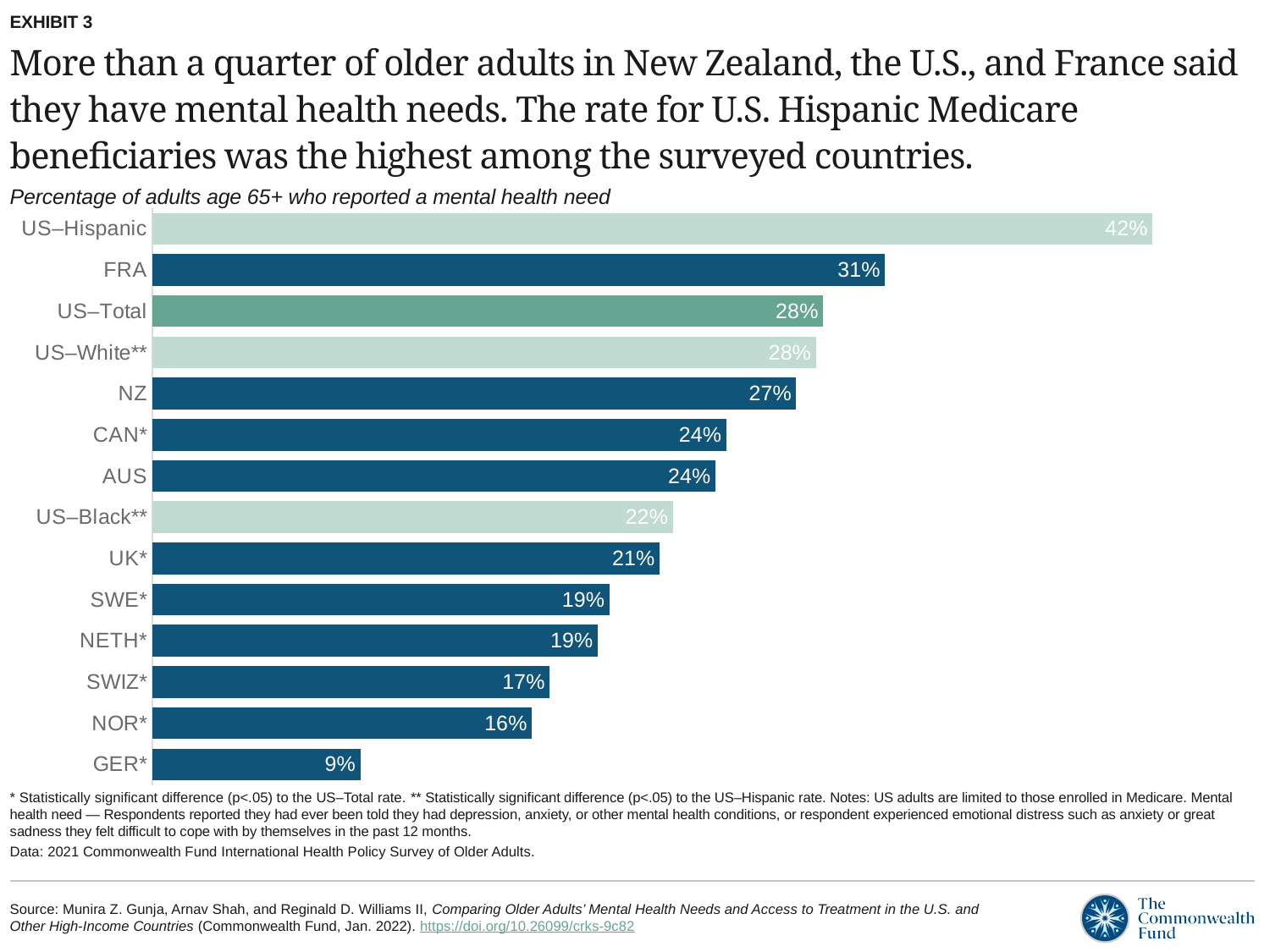
What is the difference between the FRA value and the GER* value? 22 What is the difference in percentage points between US–Hispanic and US–Total? 14 Which is larger, the value for UK* or the value for SWE*? UK* What type of chart is shown on the slide? Bar chart Which category has the highest percentage of adults reporting a mental health need? US–Hispanic Which category has the lowest percentage? GER* What is the subtitle describing what the chart measures? Percentage of adults age 65+ who reported a mental health need What is the value for GER*? 9% What percentage of US–Hispanic adults age 65+ reported a mental health need? 42% What is the value shown for FRA? 31% What percentage is shown for NZ? 27% How many categories (bars) are shown in the chart? 14